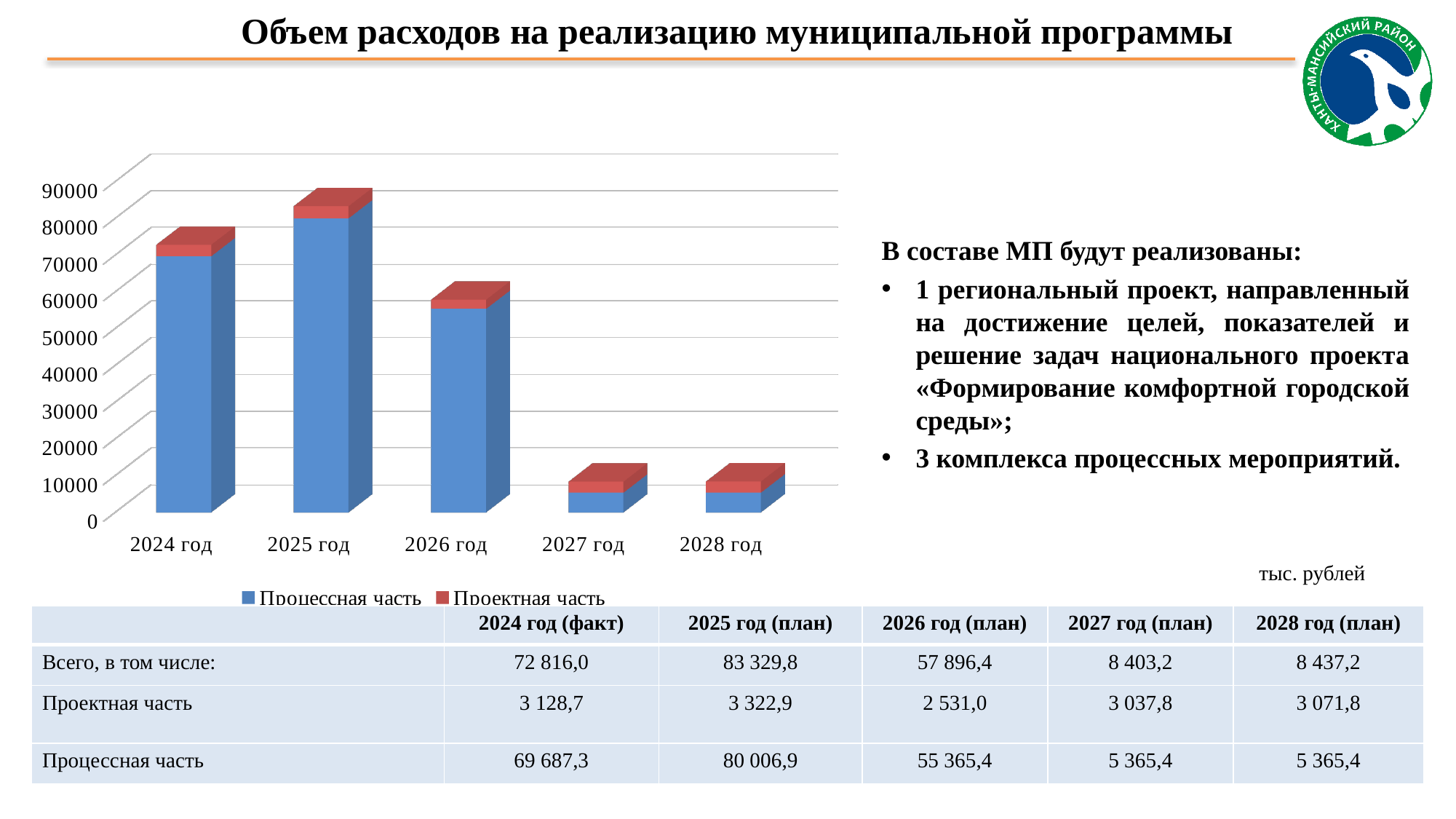
Which year has the tallest stacked bar in the chart? 2025 год What are the two series names listed in the chart legend? Процессная часть, Проектная часть What kind of chart is shown on the slide? bar chart Which stacked bar is taller, 2024 год or 2026 год? 2024 год According to the table under the chart, what is the value of Проектная часть for 2025 год (план)? 3 322,9 Is the total stacked bar for 2027 год greater or less than 10000? less Is the value of Процессная часть for 2026 год greater or less than 50000? greater How many series does the chart legend list? 2 How many year categories are shown on the x axis of the chart? 5 Using the table values, what is the difference between the totals for 2025 год (план) and 2024 год (факт)? 10 513,8 Do the stacked bar totals rise or fall from 2025 год to 2028 год? fall According to the table under the chart, what is the total (Всего) for 2024 год (факт)? 72 816,0